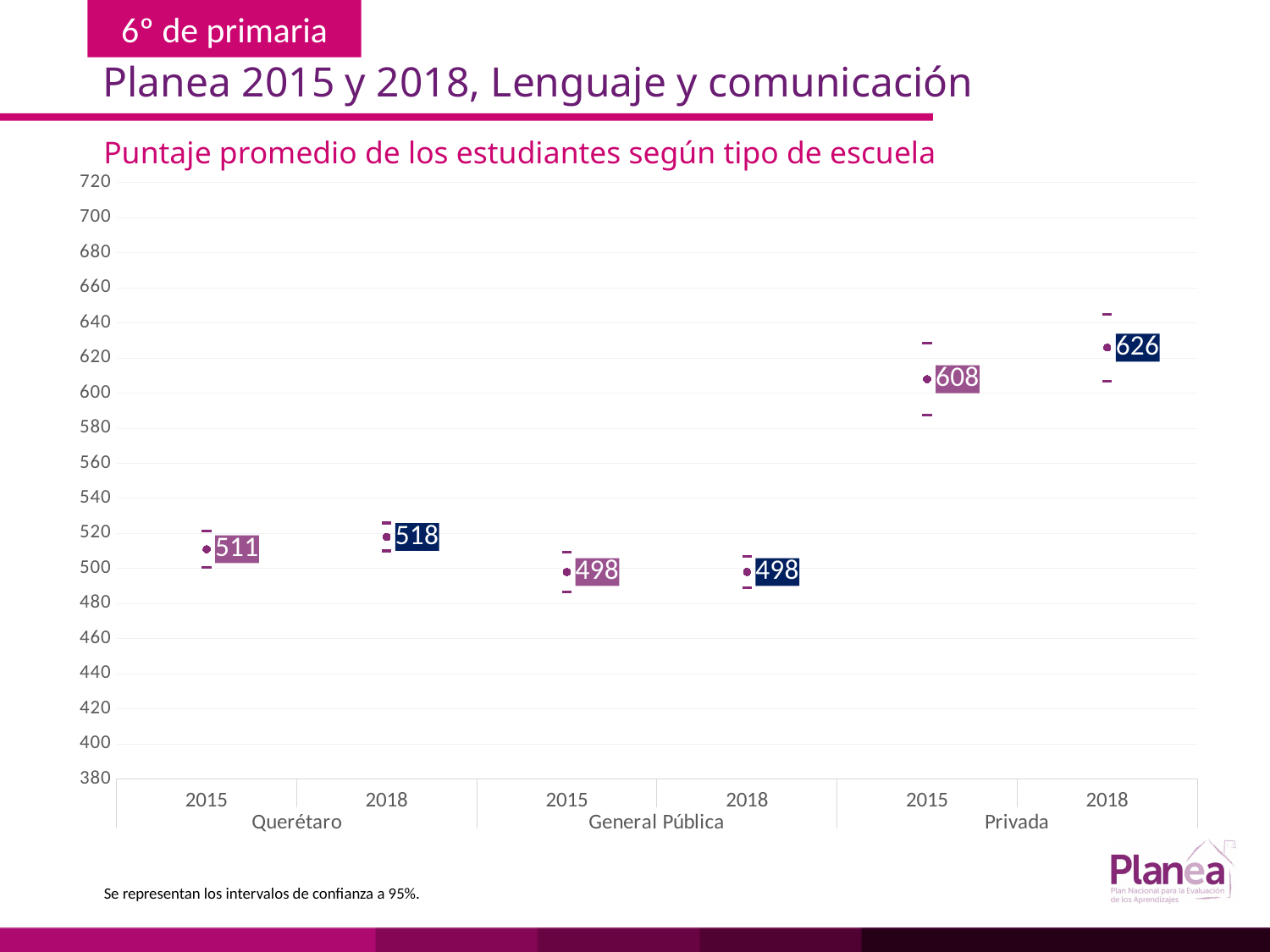
Which is larger, the Querétaro 2018 score or the General Pública 2018 score? Querétaro 2018 What is the difference between the Querétaro scores in 2018 and 2015? 7 What is the average score for Querétaro in 2015? 511 What is the difference between the Privada scores in 2018 and 2015? 18 Did the General Pública score change between 2015 and 2018? No, it stayed at 498 What is the average score for General Pública in 2018? 498 Which school type and year has the highest average score? Privada 2018 What is the average score for Privada in 2015? 608 What is the title of the chart? Puntaje promedio de los estudiantes según tipo de escuela What is the average score for Privada in 2018? 626 What is the average score for Querétaro in 2018? 518